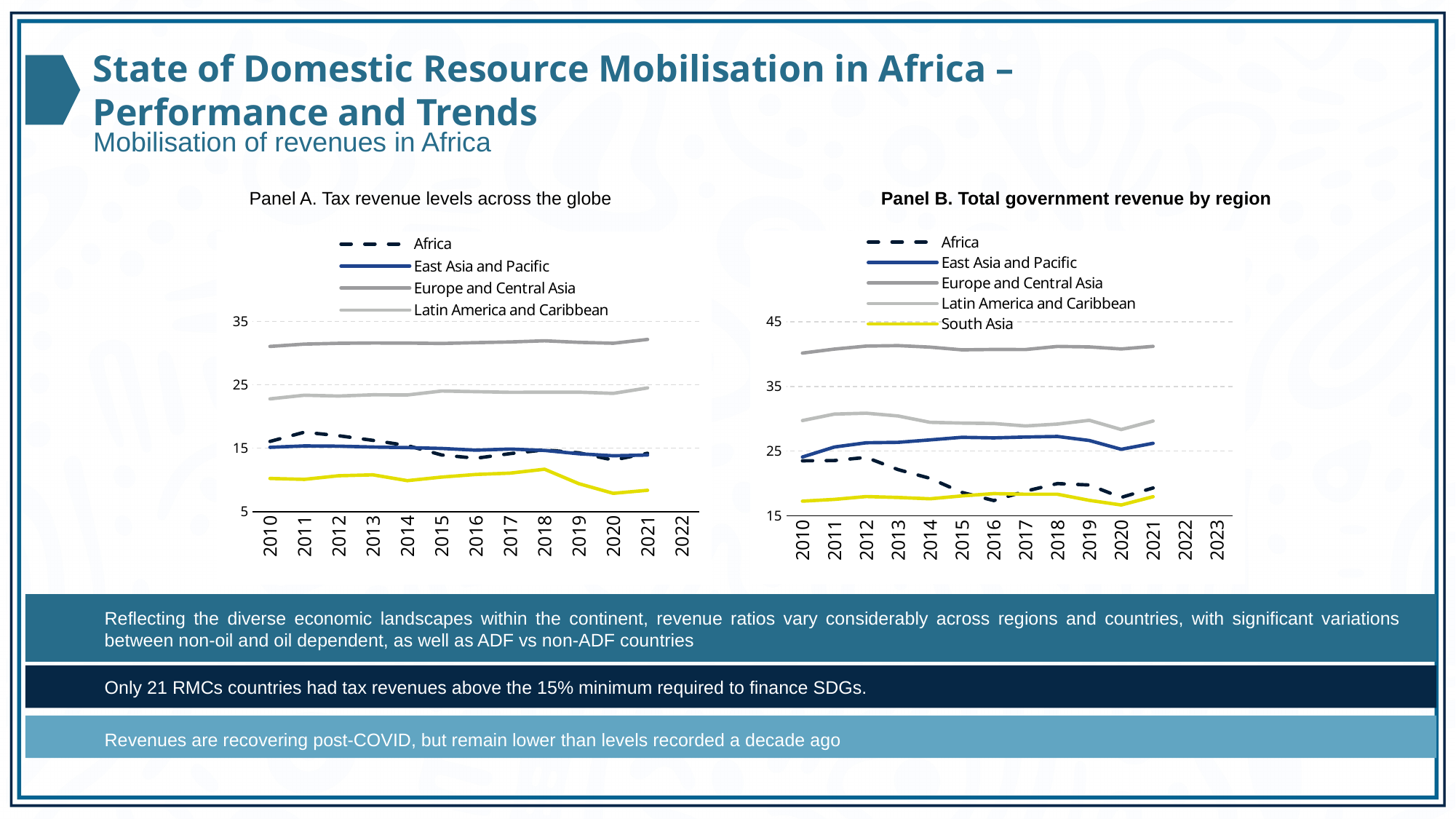
In Panel A. Tax revenue levels across the globe, which region has the highest tax revenue level throughout the period? Europe and Central Asia How many series does the legend of Panel A. Tax revenue levels across the globe list? 4 In Panel B. Total government revenue by region, is the value for Africa in 2016 greater or less than 25? less In Panel B. Total government revenue by region, which is larger in 2018: Latin America and Caribbean or South Asia? Latin America and Caribbean How many series does the legend of Panel B. Total government revenue by region list? 5 In Panel A. Tax revenue levels across the globe, is the value for Europe and Central Asia in 2021 greater or less than 25? greater In Panel B. Total government revenue by region, is the value for Europe and Central Asia in 2010 greater or less than 35? greater In Panel B. Total government revenue by region, does the Africa line rise or fall between 2010 and 2021? fall In Panel B. Total government revenue by region, which region has the highest total government revenue throughout the period? Europe and Central Asia What kind of chart is Panel A. Tax revenue levels across the globe? line chart In Panel A. Tax revenue levels across the globe, which series is drawn with a dashed line? Africa